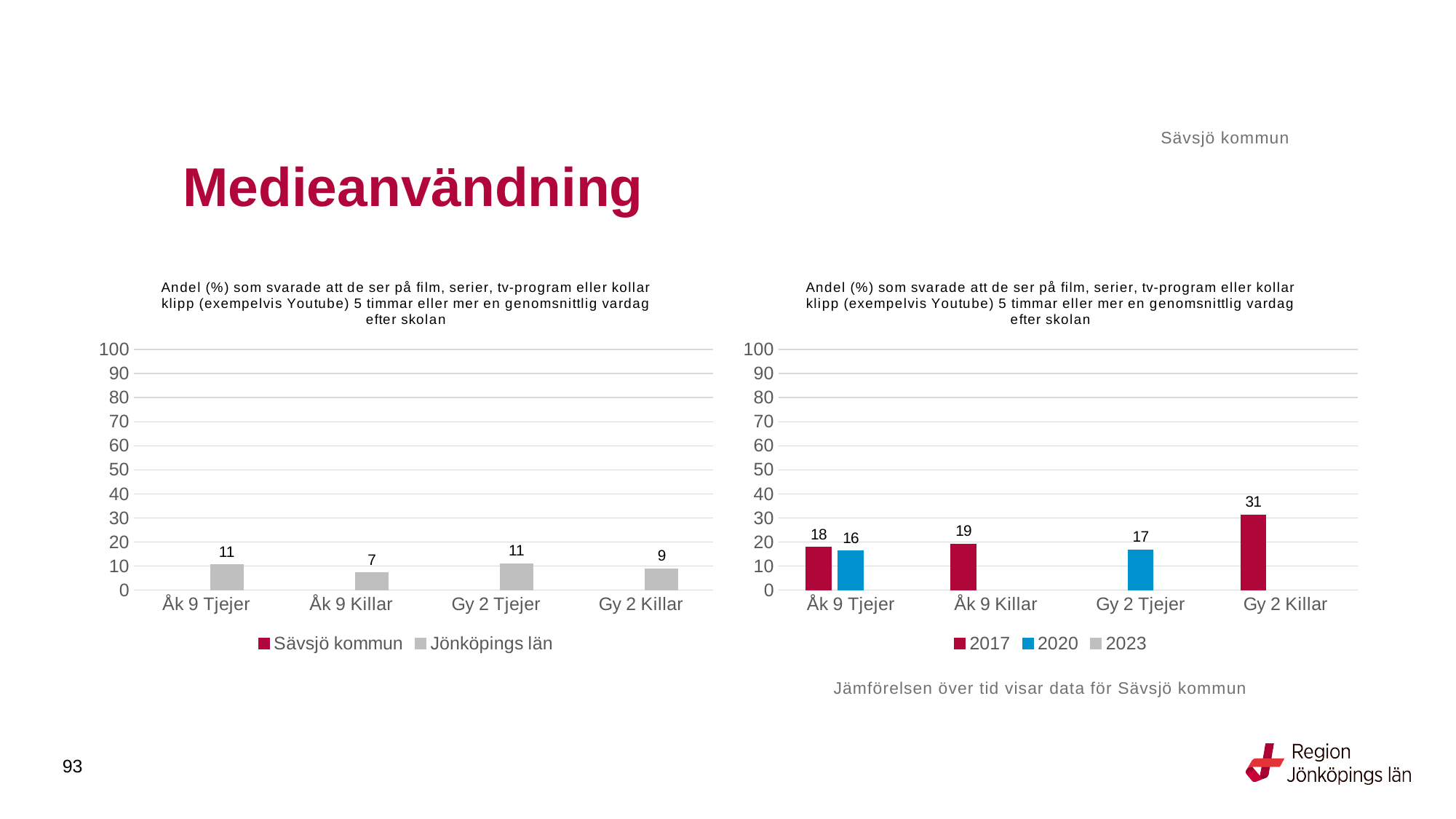
What kind of chart is the right chart? Bar chart In the right chart, what is the difference between the 2017 and 2020 values for Åk 9 Tjejer? 2 In the left chart, what is the value for Jönköpings län for Åk 9 Killar? 7 In the left chart, what is the value for Jönköpings län for Gy 2 Killar? 9 In the right chart, is the 2017 value for Gy 2 Killar greater or less than 30? greater In the right chart, how many series does the legend list? 3 In the left chart, how many series does the legend list? 2 In the left chart, what is the difference between the Jönköpings län values for Gy 2 Tjejer and Gy 2 Killar? 2 In the right chart, what is the 2020 value for Åk 9 Tjejer? 16 In the right chart, which category has the highest 2017 value? Gy 2 Killar In the left chart, which category has the lowest value for Jönköpings län? Åk 9 Killar In the right chart, what is the 2017 value for Gy 2 Killar? 31